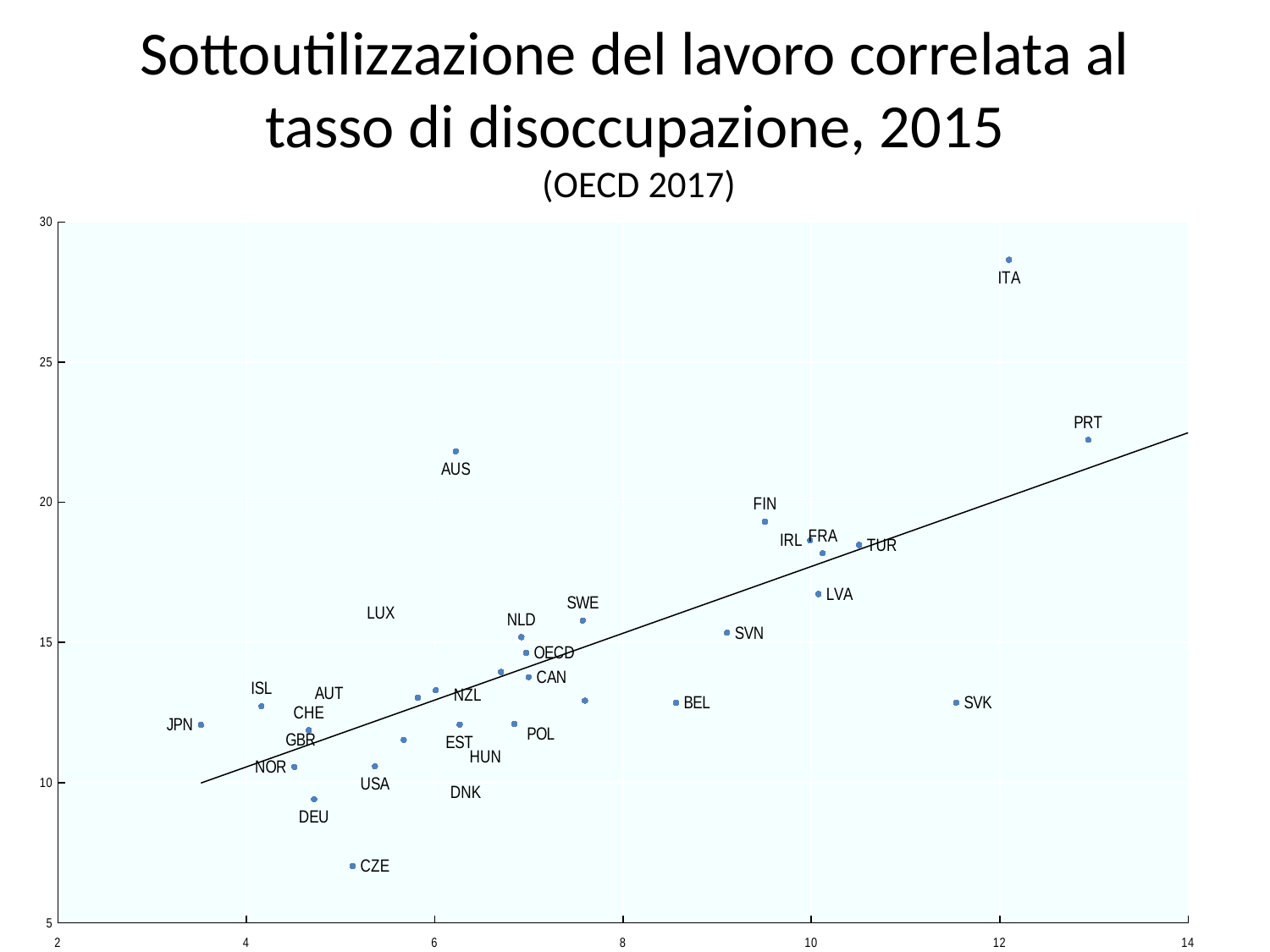
What kind of chart is shown on the slide? scatter plot Which country has the lowest value on the horizontal axis? JPN Which country has the highest value on the horizontal axis? PRT Is the horizontal-axis value for SVK greater or less than 10? greater Is the vertical-axis value for ITA greater or less than 25? greater Is the vertical-axis value for AUS greater or less than 20? greater Which has the higher vertical-axis value, AUS or FIN? AUS What is the title of the chart? Sottoutilizzazione del lavoro correlata al tasso di disoccupazione, 2015 Does the fitted trend line rise or fall as the horizontal-axis value increases? rises Which country has the highest value on the vertical axis? ITA Which country has the lowest value on the vertical axis? CZE